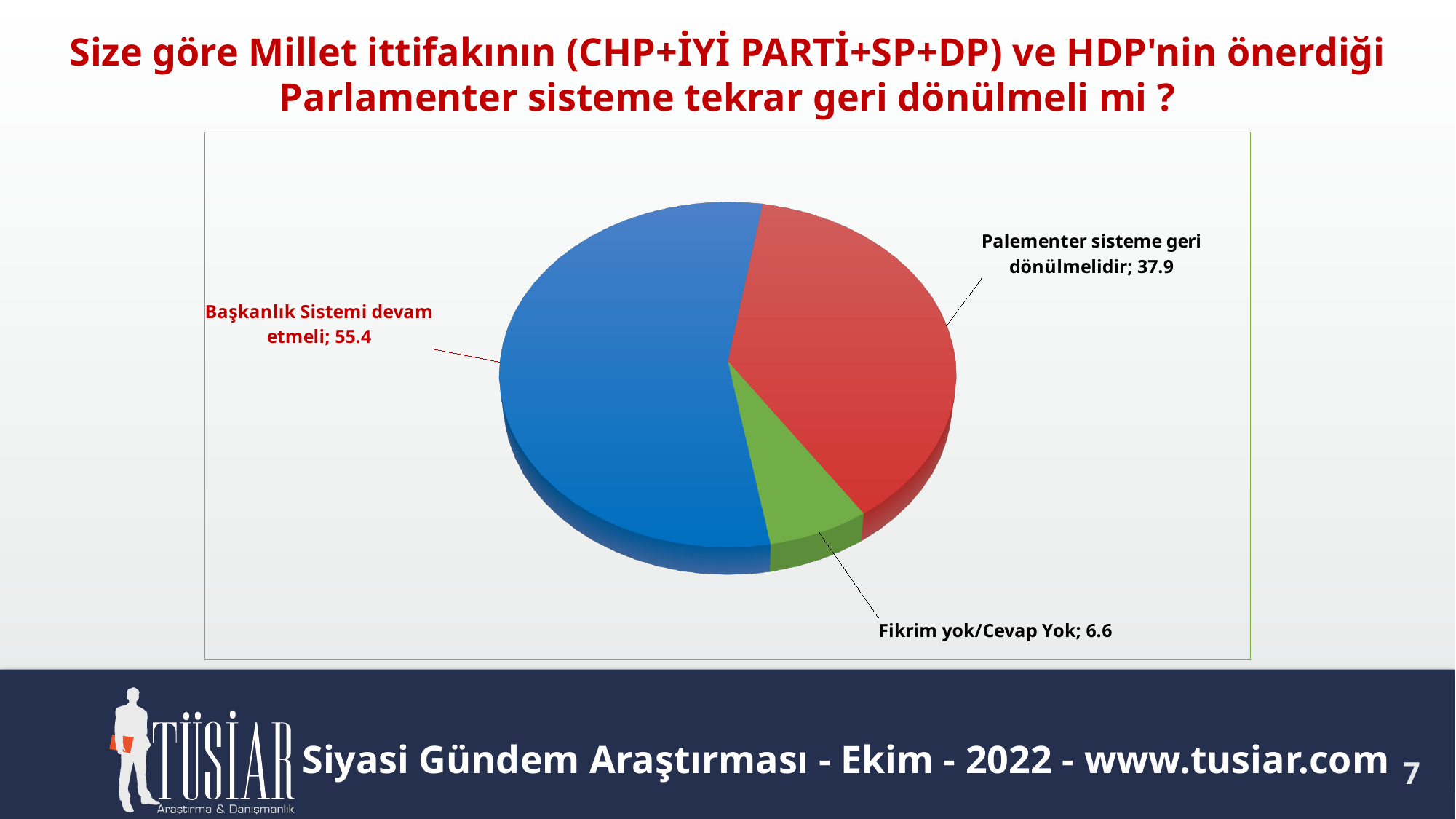
What is the difference between the values for "Başkanlık Sistemi devam etmeli" and "Palementer sisteme geri dönülmelidir"? 17.5 What is the difference between the values for "Palementer sisteme geri dönülmelidir" and "Fikrim yok/Cevap Yok"? 31.3 What is the value for "Palementer sisteme geri dönülmelidir"? 37.9 Which is larger: the value for "Palementer sisteme geri dönülmelidir" or the value for "Fikrim yok/Cevap Yok"? Palementer sisteme geri dönülmelidir What colour is the slice for "Fikrim yok/Cevap Yok"? Green What is the value for "Başkanlık Sistemi devam etmeli"? 55.4 What kind of chart is shown on the slide? Pie chart What colour is the slice for "Başkanlık Sistemi devam etmeli"? Blue Which category has the largest slice of the pie? Başkanlık Sistemi devam etmeli What is the value for "Fikrim yok/Cevap Yok"? 6.6 Which category has the smallest slice of the pie? Fikrim yok/Cevap Yok How many slices does the pie chart have? 3